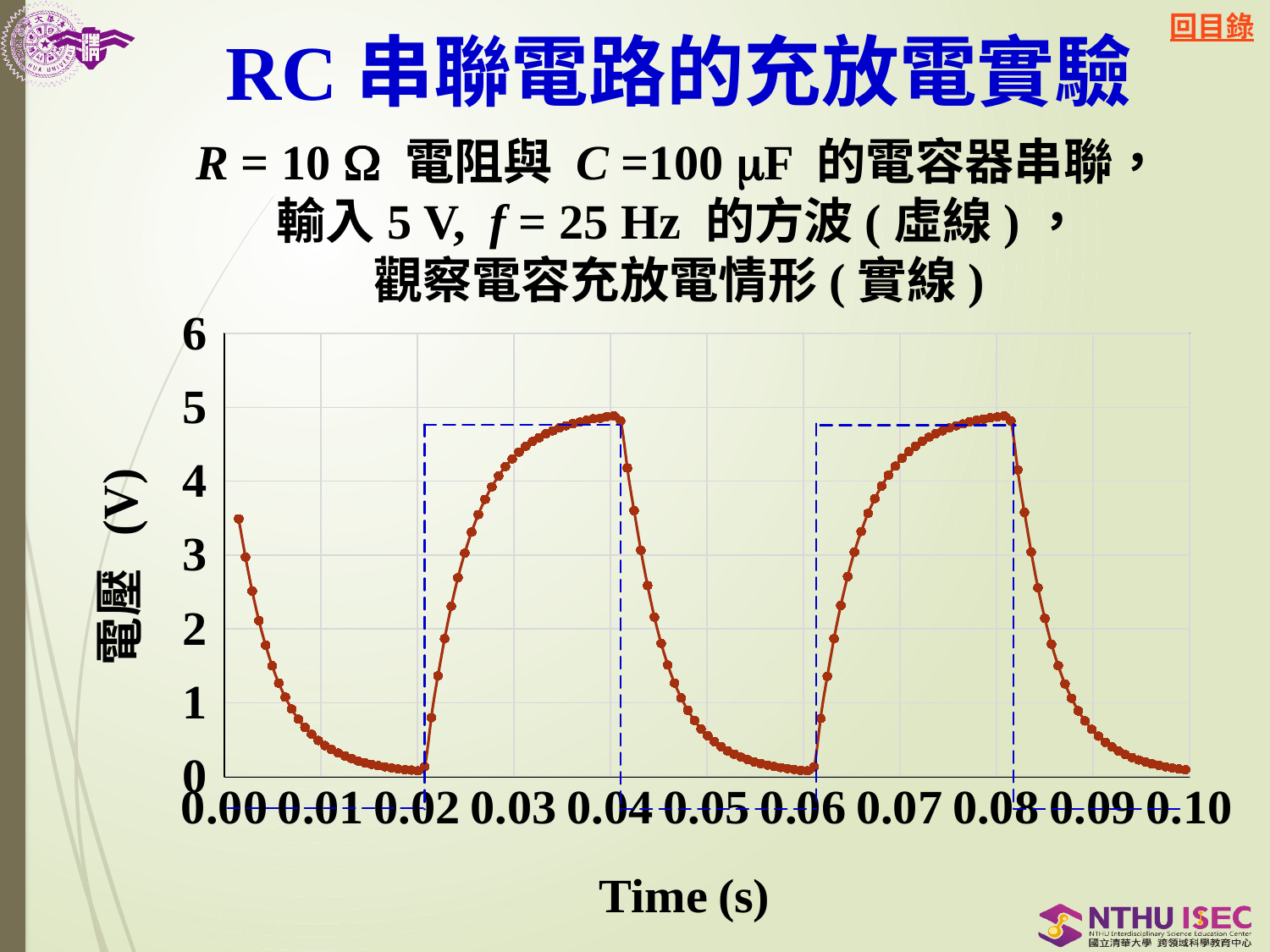
Is the value of the solid line at time 0.00 greater or less than 3? greater Is the value of the solid line at time 0.04 greater or less than 4? greater Does the solid line rise or fall between time 0.02 and time 0.04? rise What is the largest time value shown on the horizontal axis? 0.10 What is the highest value shown on the vertical axis of the chart? 6 Is the high level of the dashed square wave greater or less than 4? greater What kind of chart is shown on the slide? line chart Does the solid line rise or fall between time 0.04 and time 0.06? fall What is the label of the horizontal axis of the chart? Time (s) Which is larger, the value of the solid line at time 0.03 or at time 0.05? at time 0.03